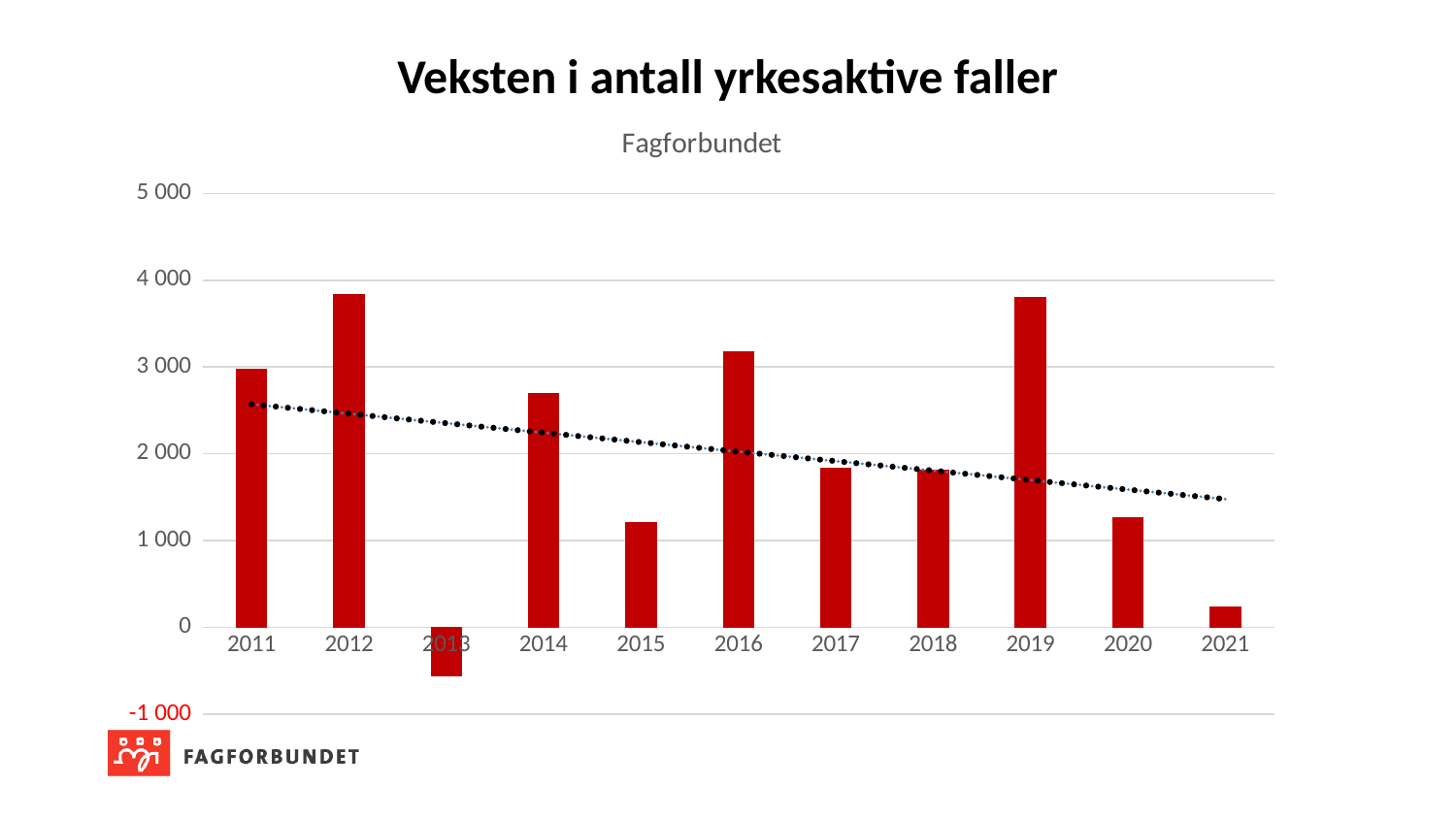
What is the title of the chart? Fagforbundet How many years are shown on the x axis of the chart? 11 Is the value for 2012 greater or less than 3 000? greater Which year has the larger value, 2011 or 2014? 2011 Does the dotted trend line rise or fall from 2011 to 2021? fall What kind of chart is shown on the slide? bar chart Is the value for 2013 greater or less than 0? less Which year has the lowest value in the chart? 2013 Is the value for 2016 greater or less than 3 000? greater Which year has the larger value, 2016 or 2017? 2016